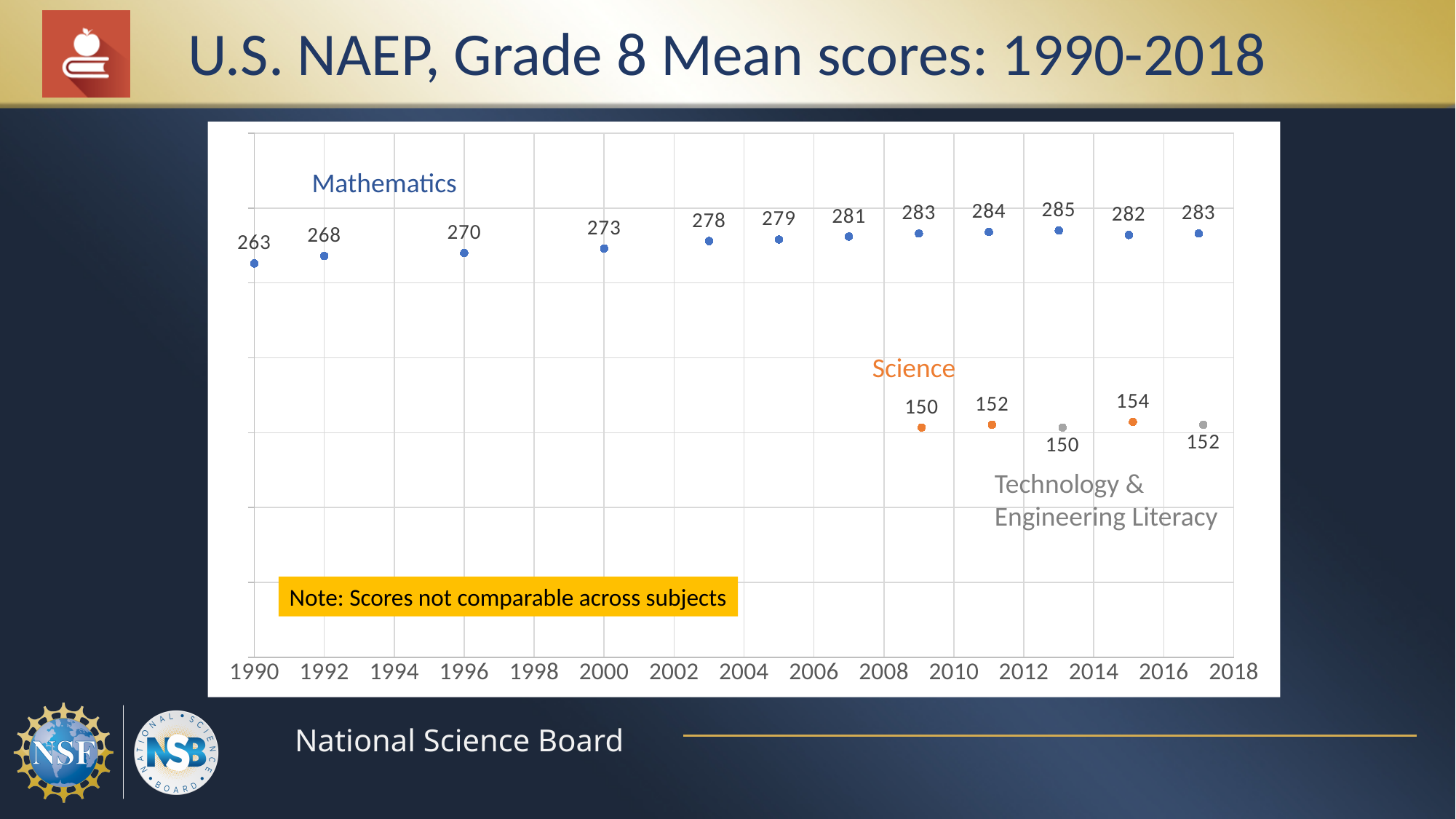
What is the Mathematics mean score for 2000? 273 What is the highest Mathematics mean score shown on the chart? 285 How many Science data points are plotted on the chart? 3 What is the Mathematics mean score for 1990? 263 What is the lowest Mathematics mean score shown on the chart? 263 What is the highest Science mean score shown on the chart? 154 How many subject series are plotted on the chart? 3 How many Mathematics data points are plotted on the chart? 12 What kind of chart is shown on the slide? scatter chart What does the yellow note on the chart say? Note: Scores not comparable across subjects What is the difference between the highest and lowest Mathematics mean scores shown? 22 Do the Mathematics mean scores generally rise or fall from 1990 to 2018? rise